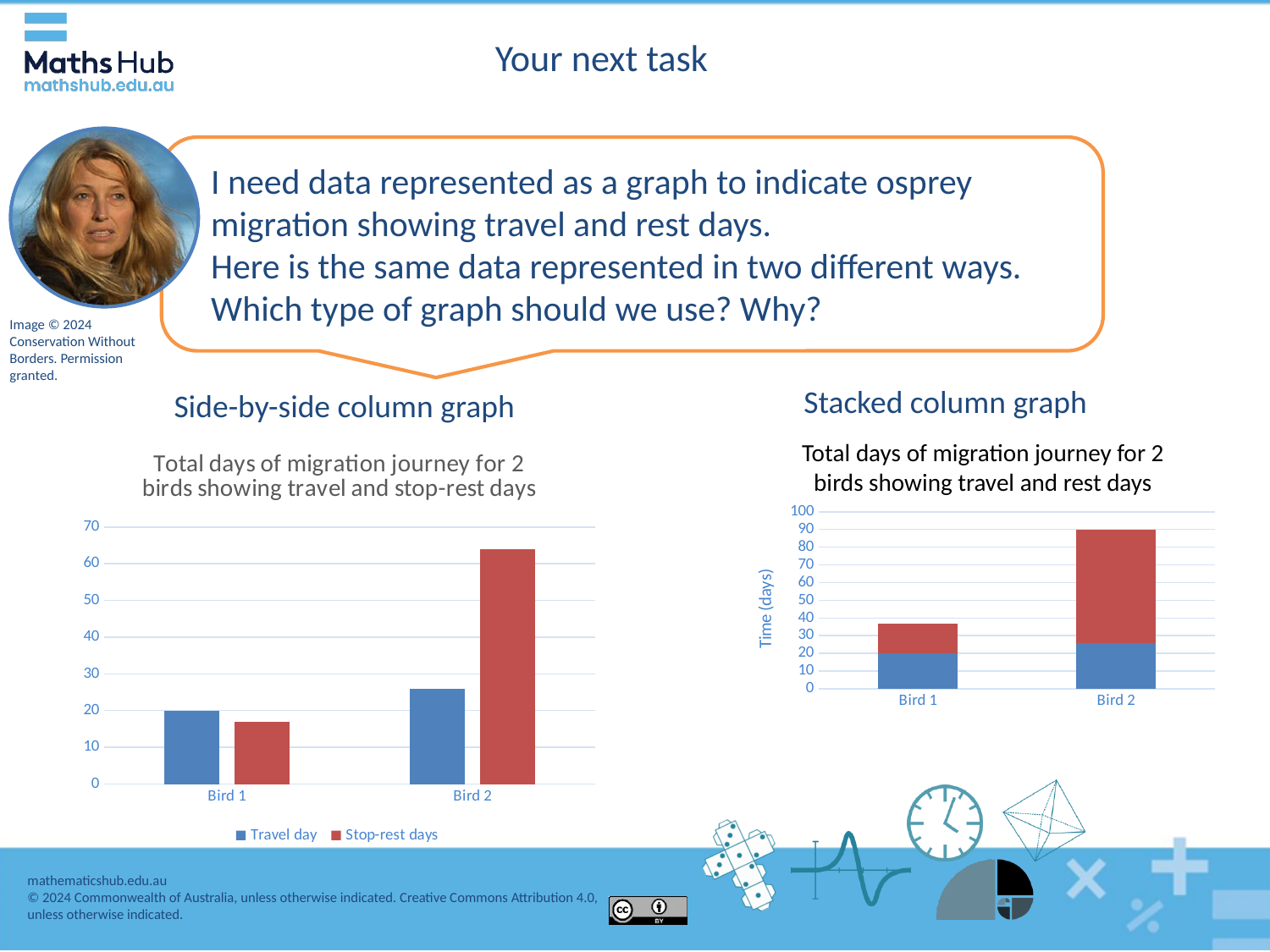
In the side-by-side column graph, how many series does the legend list? 2 In the side-by-side column graph, which bird has the higher value for Stop-rest days? Bird 2 In the side-by-side column graph, is the Stop-rest days value for Bird 1 greater or less than 20? less What kind of chart is the stacked column graph on the right? stacked bar chart In the side-by-side column graph, is the Travel day value for Bird 2 greater or less than 30? less In the side-by-side column graph, is the Stop-rest days value for Bird 2 greater or less than 60? greater What is the y-axis label on the stacked column graph? Time (days) In the stacked column graph, which bird has the taller stacked bar? Bird 2 In the side-by-side column graph, which is larger for Bird 2: Travel day or Stop-rest days? Stop-rest days What kind of chart is the side-by-side column graph on the left? bar chart In the side-by-side column graph, how many categories are shown on the x axis? 2